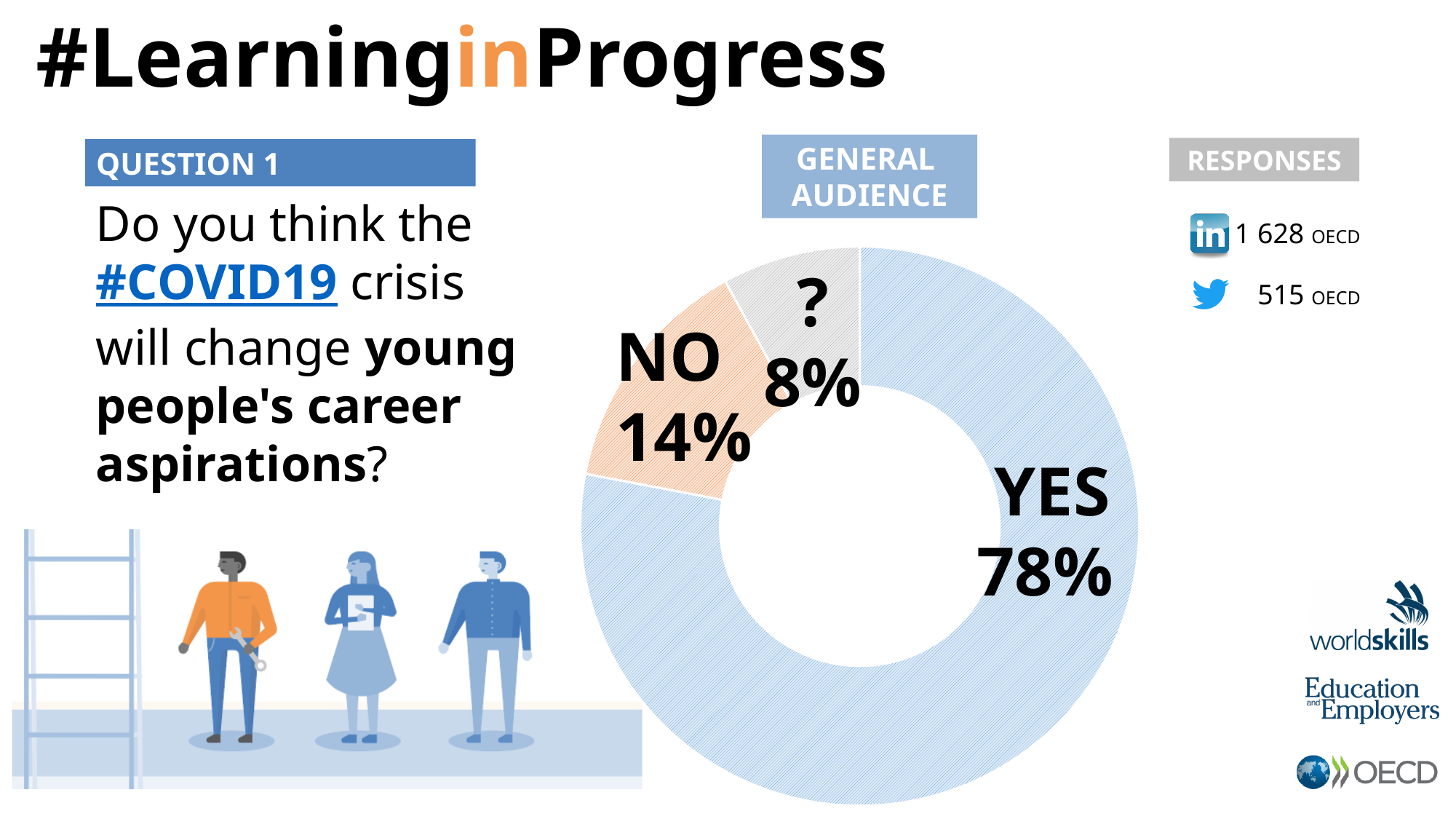
What is the combined share of the NO and '?' responses? 22% What percentage of the general audience answered YES? 78% Which audience does the chart represent, according to the label above it? General audience How many response categories are shown in the chart? 3 Which response has the smallest share of the chart? ? (8%) What is the difference in percentage points between the YES and NO responses? 64 Which response is larger, NO or '?'? NO What kind of chart is used to show the responses? Doughnut (pie) chart What percentage of the general audience answered NO? 14% What colour is the YES segment of the chart? Light blue Which response has the largest share of the chart? YES What percentage of the general audience answered '?' (unsure)? 8%